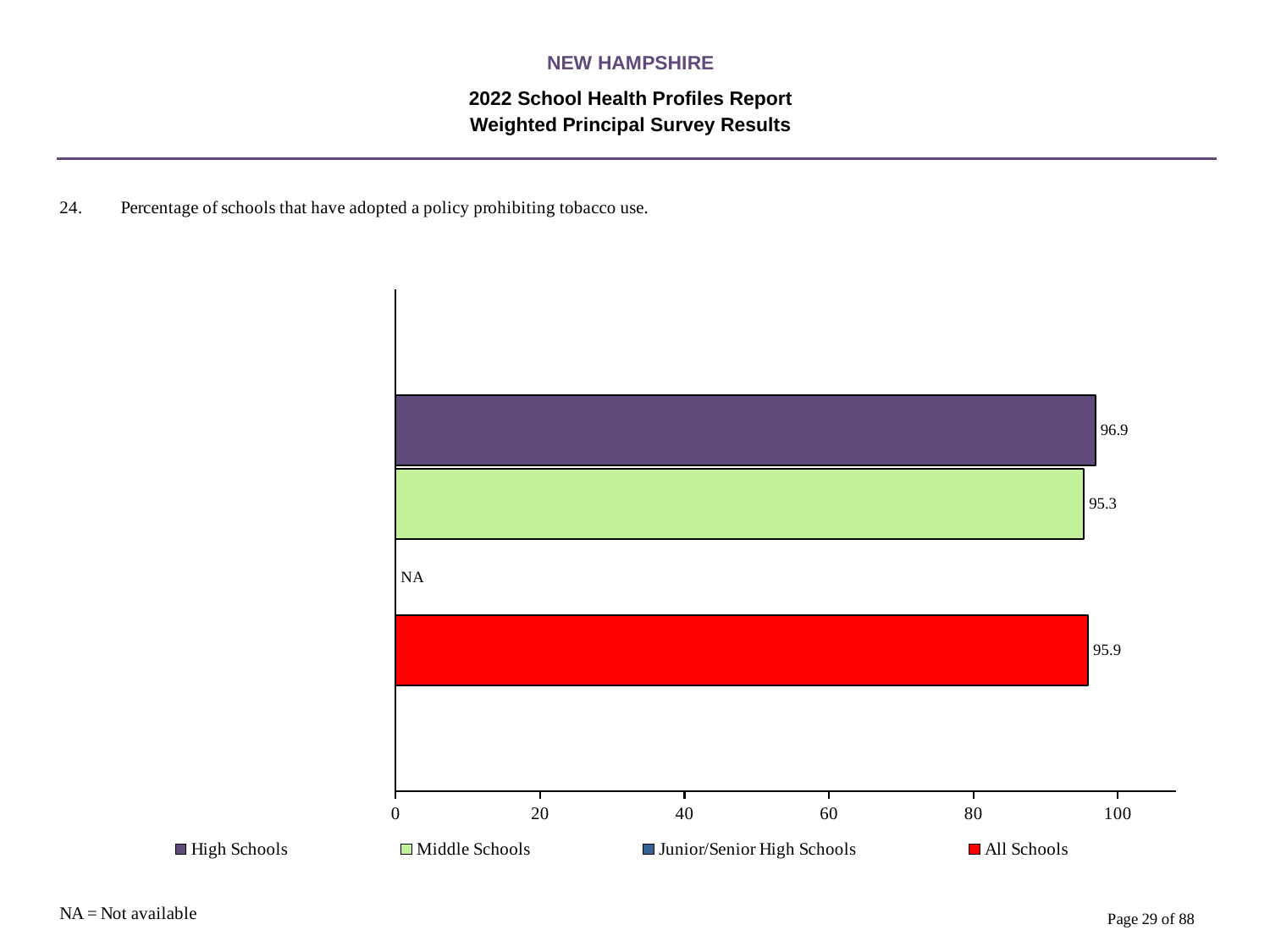
What is the difference between the All Schools value and the Middle Schools value? 0.6 What is the value for High Schools? 96.9 What kind of chart is shown? bar chart How many series does the legend list? 4 Which school type with a plotted value has the lowest value? Middle Schools What is shown for Junior/Senior High Schools? NA What is the value for All Schools? 95.9 Which school type has the highest value? High Schools What is the value for Middle Schools? 95.3 Is the value for All Schools greater or less than 80? greater What is the difference between the High Schools value and the Middle Schools value? 1.6 What colour is the All Schools bar? red